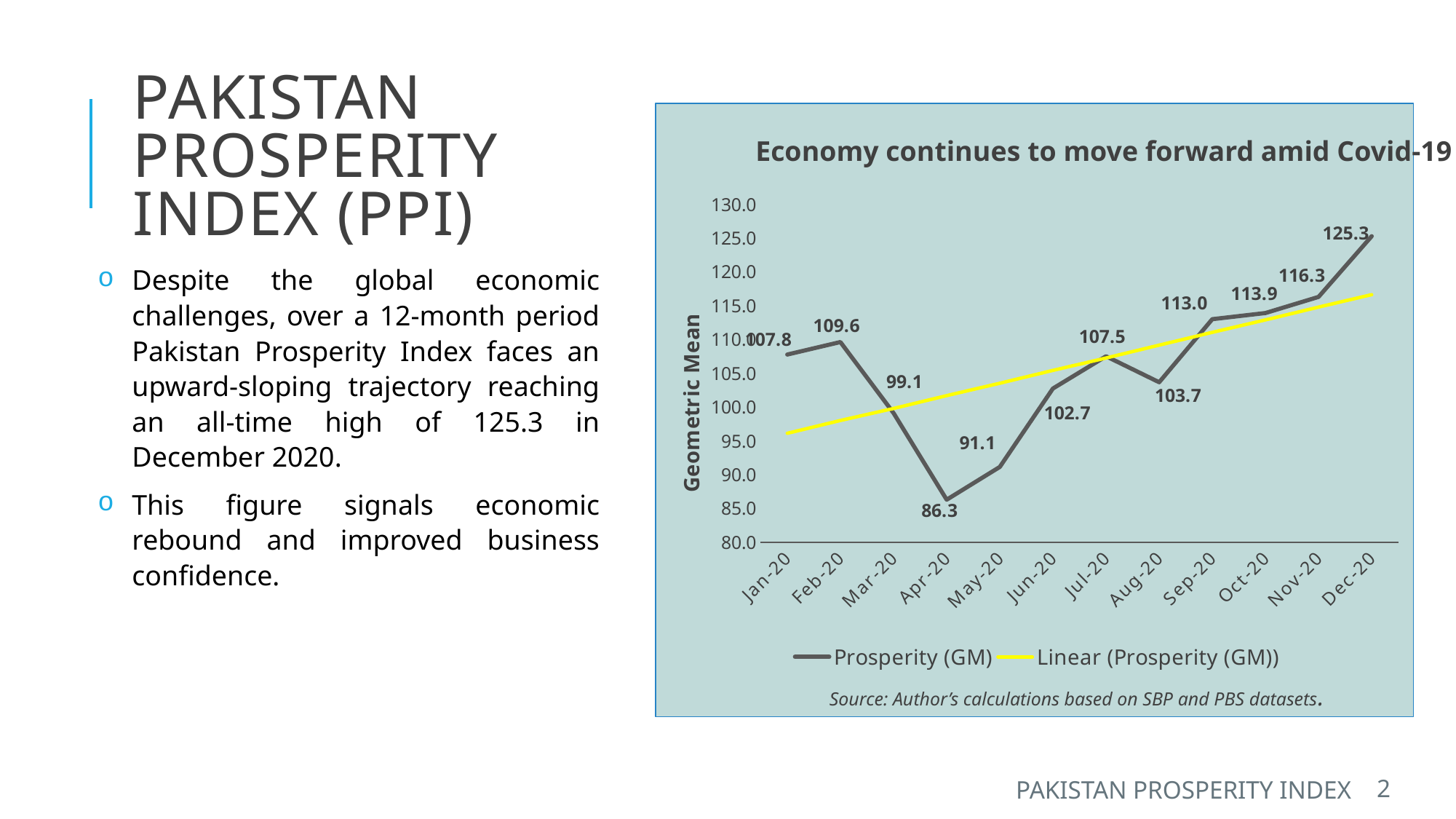
How many months are plotted on the x axis? 12 Which month has the lowest Prosperity (GM) value? Apr-20 Which month has a higher Prosperity (GM) value, Aug-20 or Sep-20? Sep-20 What is the Prosperity (GM) value for Dec-20? 125.3 What kind of chart is shown on the slide? Line chart What is the difference between the Prosperity (GM) values for Feb-20 and Mar-20? 10.5 What is the Prosperity (GM) value for Apr-20? 86.3 Which month has the highest Prosperity (GM) value? Dec-20 How many series does the legend list? 2 Is the Prosperity (GM) value for May-20 greater or less than 95.0? less What is the Prosperity (GM) value for Jul-20? 107.5 By how much did the Prosperity (GM) value increase from Nov-20 to Dec-20? 9.0